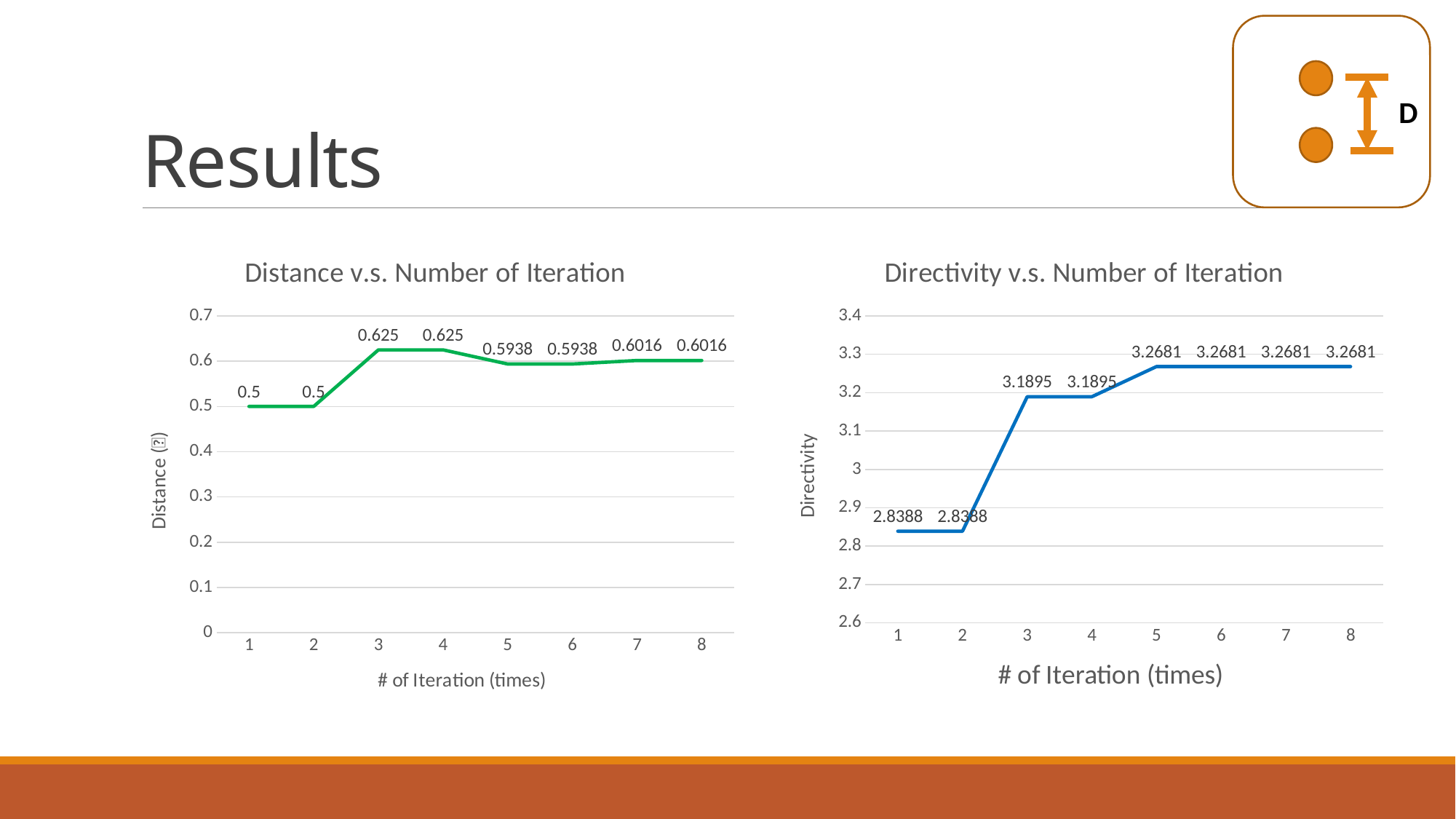
In the 'Distance v.s. Number of Iteration' chart, what is the distance at iteration 3? 0.625 What kind of chart is the 'Distance v.s. Number of Iteration' chart? line chart In the 'Distance v.s. Number of Iteration' chart, what is the lowest distance value plotted? 0.5 How many iteration points are plotted in the 'Directivity v.s. Number of Iteration' chart? 8 In the 'Directivity v.s. Number of Iteration' chart, does the directivity generally rise or fall as the number of iterations increases? rise In the 'Directivity v.s. Number of Iteration' chart, what is the highest directivity value plotted? 3.2681 In the 'Distance v.s. Number of Iteration' chart, is the distance at iteration 5 greater or less than 0.6? less In the 'Directivity v.s. Number of Iteration' chart, what is the directivity at iteration 1? 2.8388 In the 'Distance v.s. Number of Iteration' chart, what is the difference between the distance at iteration 3 and at iteration 1? 0.125 In the 'Directivity v.s. Number of Iteration' chart, is the directivity at iteration 3 larger or smaller than at iteration 5? smaller In the 'Directivity v.s. Number of Iteration' chart, what is the directivity at iteration 5? 3.2681 In the 'Distance v.s. Number of Iteration' chart, what is the distance at iteration 8? 0.6016